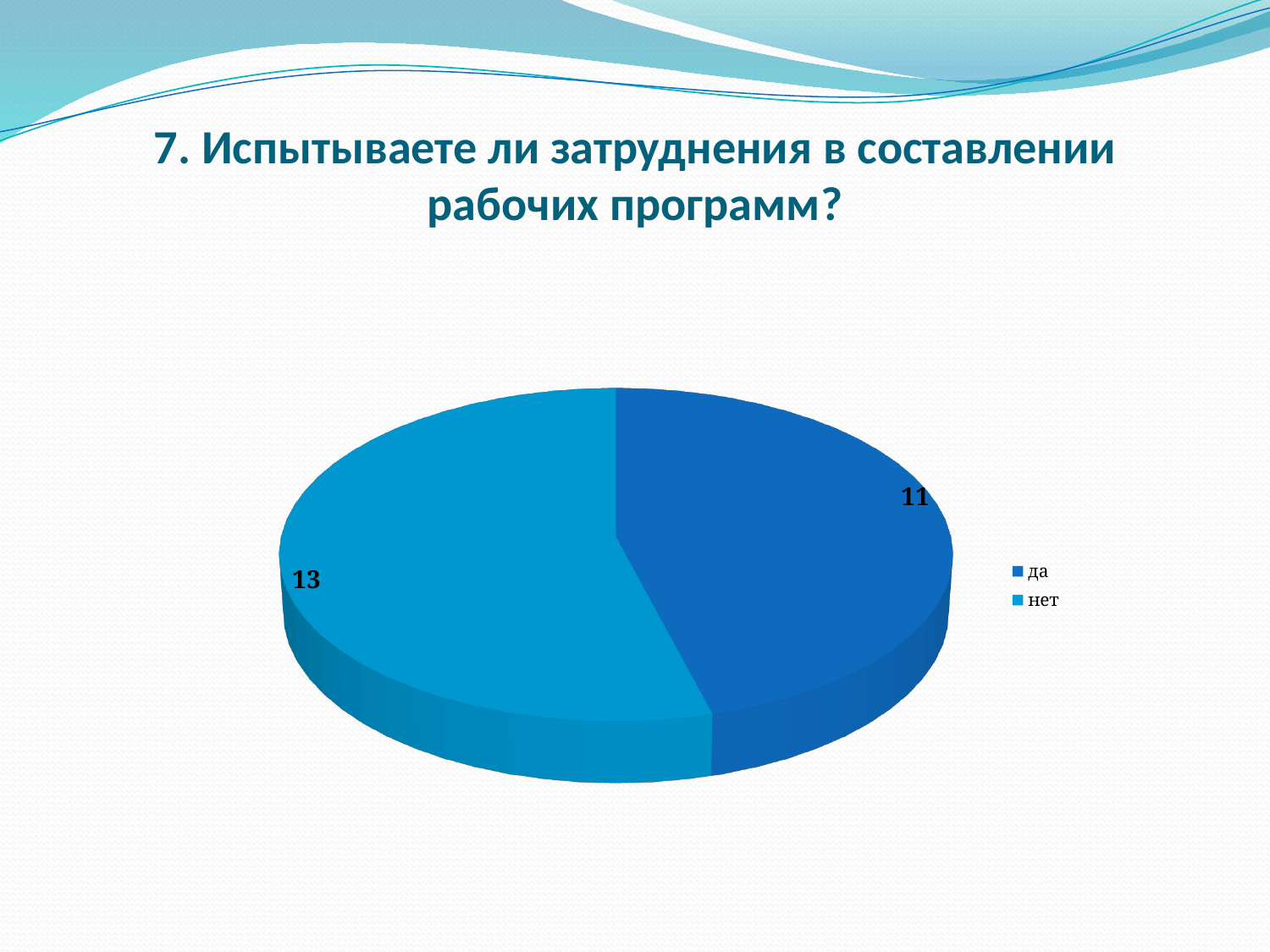
How many slices does the pie chart have? 2 Which is larger, the value for "да" or the value for "нет"? нет Which category has the largest slice? нет What is the value for "да"? 11 How many entries does the legend list? 2 What is the difference between the values for "нет" and "да"? 2 What is the title of the slide above the chart? 7. Испытываете ли затруднения в составлении рабочих программ? What is the total of all slices in the pie chart? 24 What is the value for "нет"? 13 What are the legend entries of the chart? да, нет Which category has the smallest slice? да What type of chart is shown on the slide? pie chart